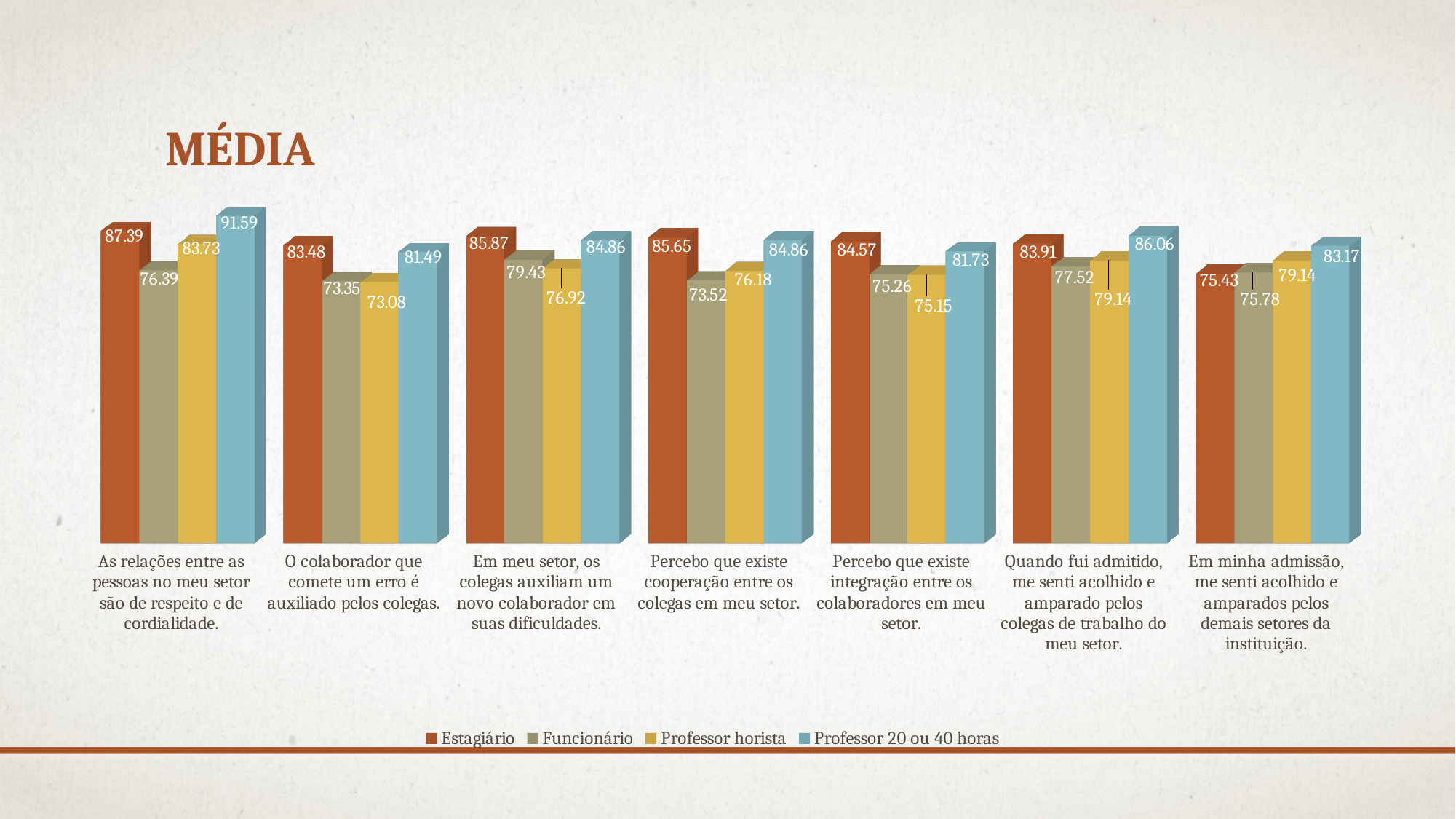
Which series has the lowest value in the category "Em meu setor, os colegas auxiliam um novo colaborador em suas dificuldades"? Professor horista What is the difference between the Professor 20 ou 40 horas value and the Funcionário value in the category "As relações entre as pessoas no meu setor são de respeito e de cordialidade"? 15.20 What is the value for Estagiário in the category "As relações entre as pessoas no meu setor são de respeito e de cordialidade"? 87.39 How many categories are shown on the x axis of the chart? 7 What is the value for Professor 20 ou 40 horas in the category "Quando fui admitido, me senti acolhido e amparado pelos colegas de trabalho do meu setor"? 86.06 In the category "Em minha admissão, me senti acolhido e amparados pelos demais setores da instituição", which is larger: the Estagiário value or the Professor 20 ou 40 horas value? Professor 20 ou 40 horas What is the value for Professor horista in the category "O colaborador que comete um erro é auxiliado pelos colegas"? 73.08 How many series does the legend list? 4 What is the value for Funcionário in the category "Percebo que existe cooperação entre os colegas em meu setor"? 73.52 What is the title of the chart? MÉDIA What kind of chart is shown on the slide? Bar chart Which series has the highest value in the category "As relações entre as pessoas no meu setor são de respeito e de cordialidade"? Professor 20 ou 40 horas